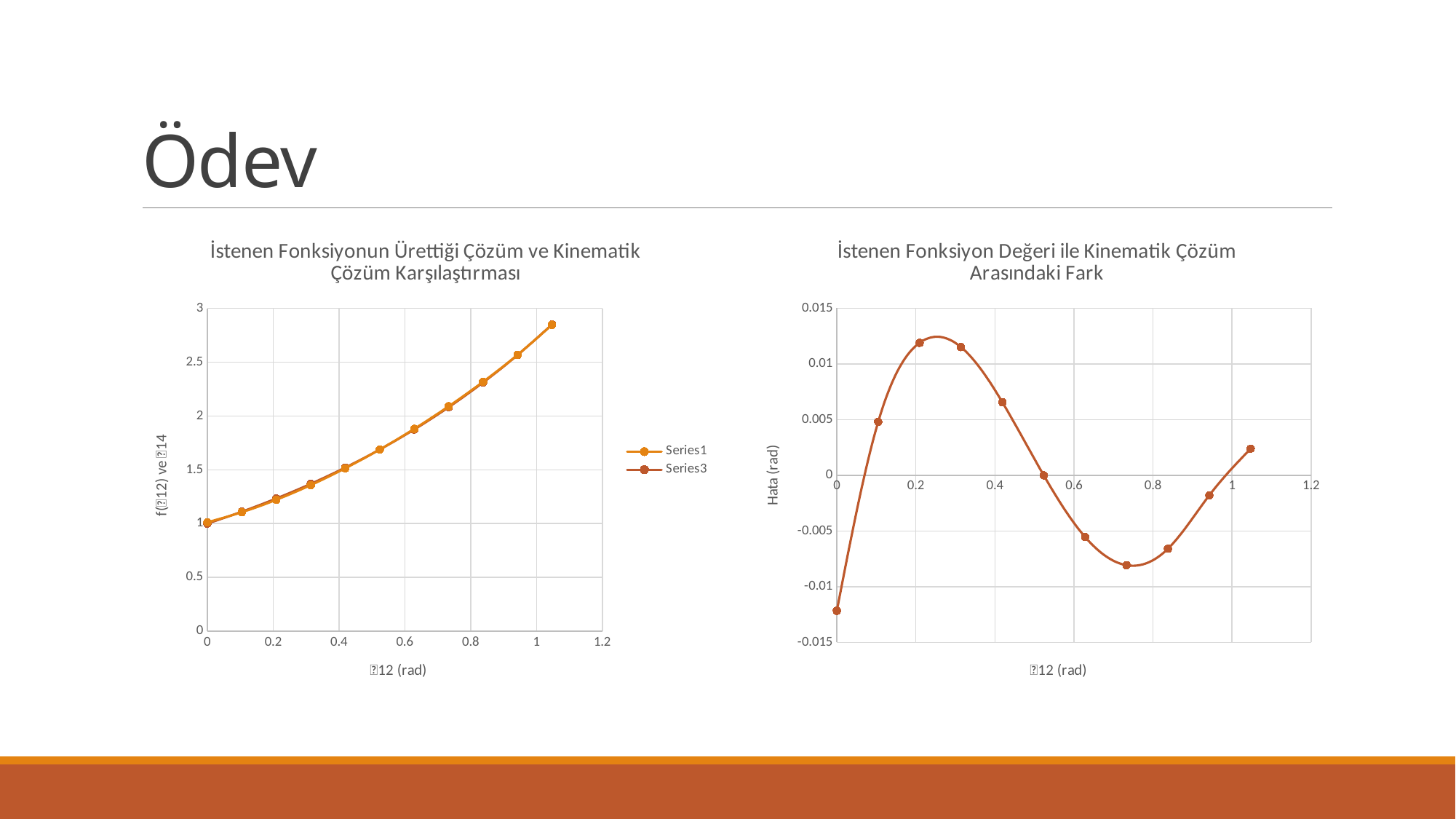
What are the names of the series in the legend of the left chart? Series1 and Series3 In the left chart, do the values rise or fall as the x axis increases? Rise In the right chart, is the error value at x ≈ 0.2 greater or less than 0.01? greater What is the y-axis label of the right chart? Hata (rad) In the left chart, is the value of Series1 at x ≈ 0.4 greater or less than 2? less In the right chart, is the error value at x = 0 greater or less than -0.01? less How many data points are plotted for each series in the left chart? 11 How many data points are plotted in the right chart? 11 What kind of chart is the left chart, 'İstenen Fonksiyonun Ürettiği Çözüm ve Kinematik Çözüm Karşılaştırması'? Line chart What kind of chart is the right chart, 'İstenen Fonksiyon Değeri ile Kinematik Çözüm Arasındaki Fark'? Line chart How many series does the legend of the left chart list? 2